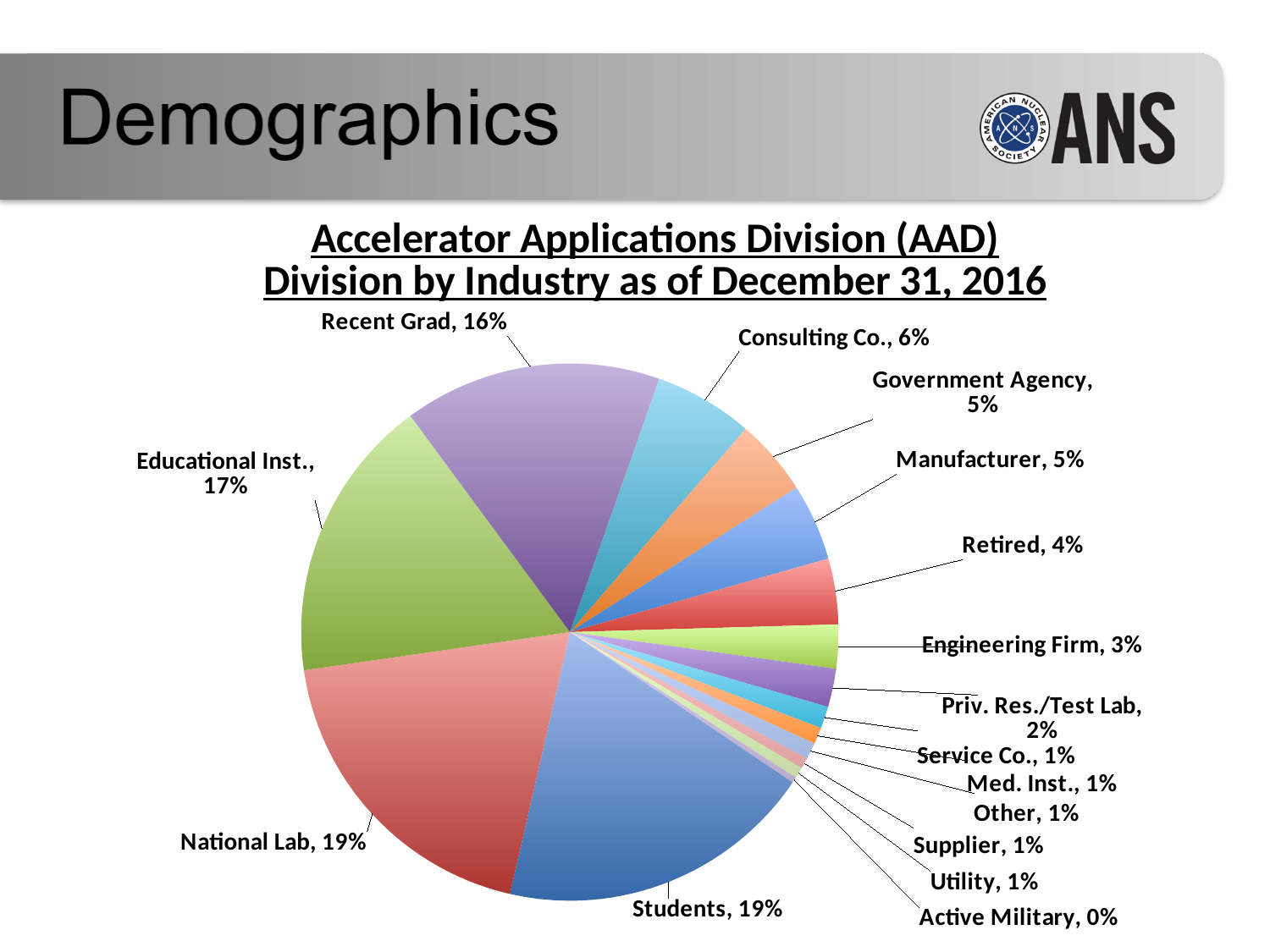
What percentage is shown for Educational Inst.? 17% Which category has the smallest share of the pie? Active Military What is the title of the chart? Accelerator Applications Division (AAD) Division by Industry as of December 31, 2016 What percentage is shown for Priv. Res./Test Lab? 2% What is the difference in percentage points between Educational Inst. and Recent Grad? 1% What percentage is shown for Engineering Firm? 3% How many categories are shown in the pie chart? 16 What share of the pie does Recent Grad represent? 16% What percentage is shown for Retired? 4% What kind of chart is shown on the slide? pie chart Which has a larger share, Consulting Co. or Government Agency? Consulting Co. What percentage is shown for Consulting Co.? 6%